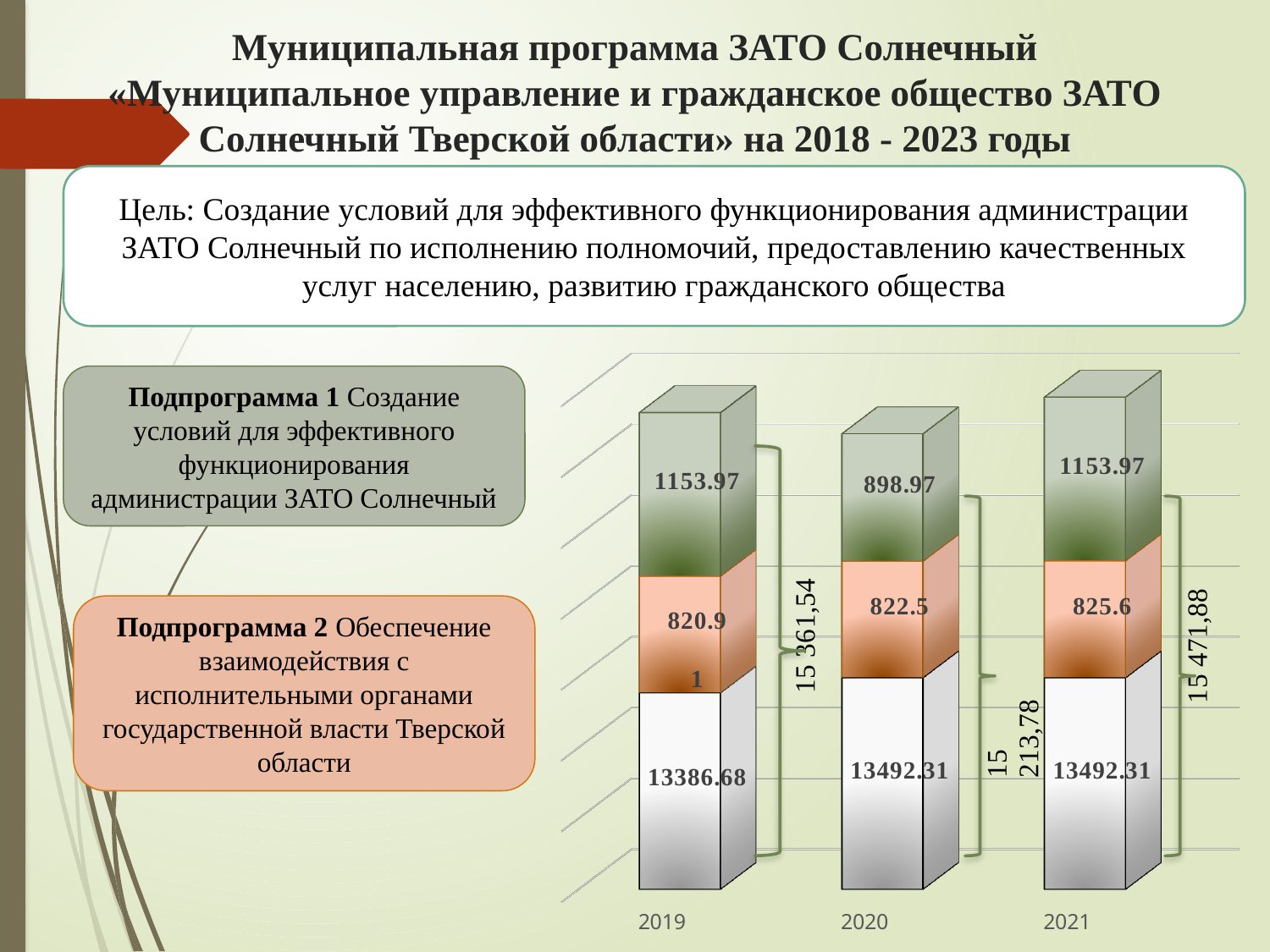
How many years (categories) are shown on the x axis of the chart? 3 Which is larger: the middle (orange) segment for 2019 or for 2020? 2020 What is the value of the top (green) segment of the 2020 bar? 898.97 What is the difference between the bottom (white) segment values for 2020 and 2019? 105.63 What is the difference between the top (green) segment values for 2019 and 2020? 255 What total is printed next to the 2019 bar? 15 361,54 What is the value of the middle (orange) segment of the 2021 bar? 825.6 What type of chart is shown on the slide? Stacked bar chart Which year has the lowest value for the top (green) segment? 2020 What total is printed next to the 2021 bar? 15 471,88 What is the value of the bottom (white) segment of the 2019 bar? 13386.68 Which year has the lowest value for the bottom (white) segment? 2019